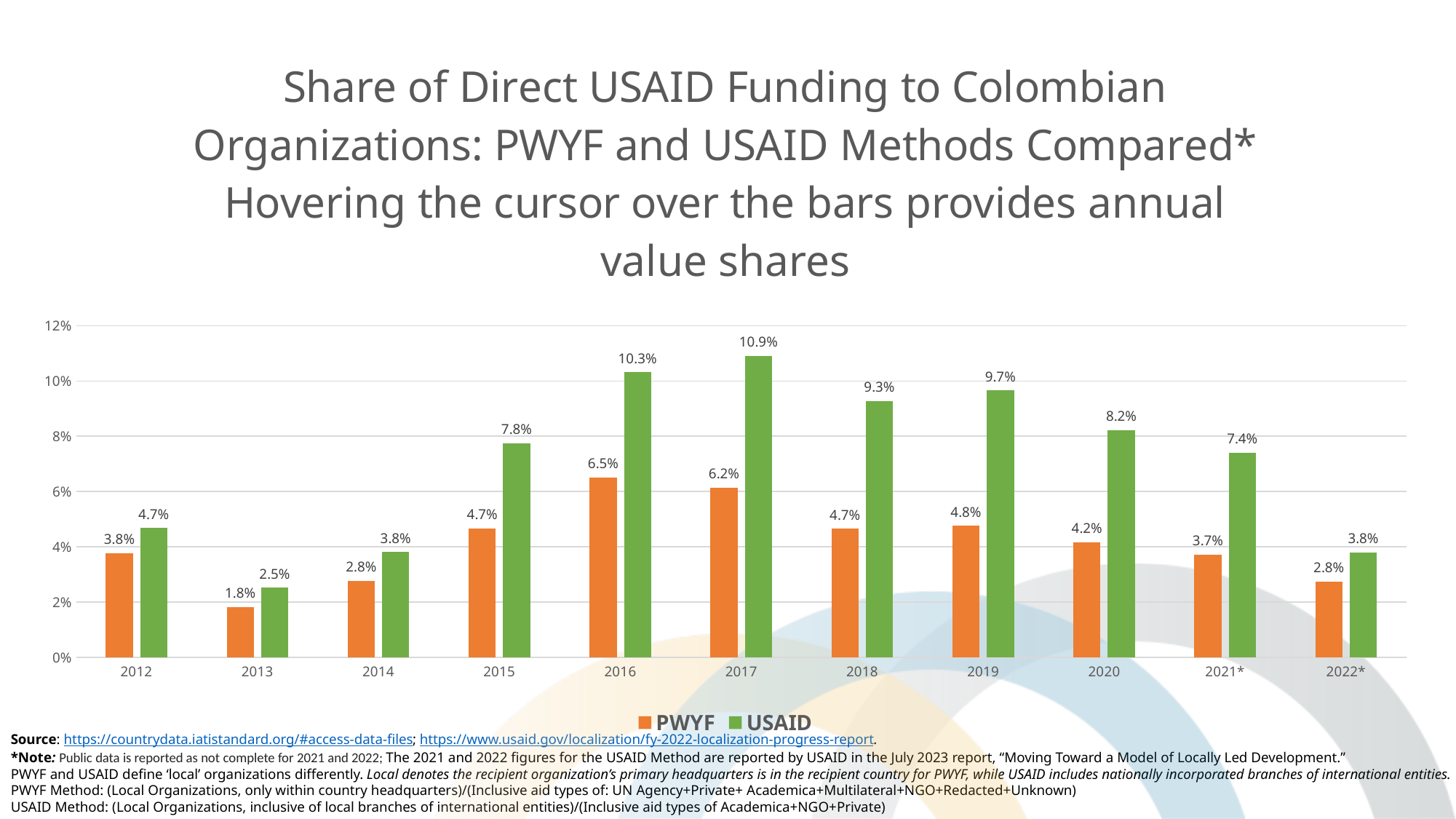
Which year has the lowest PWYF value? 2013 How many years are shown on the x axis? 11 What is the USAID value for 2017? 10.9% What kind of chart is shown on the slide? Bar chart Does the USAID value rise or fall from 2017 to 2022*? Fall Which year has the highest USAID value? 2017 Which is larger in 2019, the PWYF value or the USAID value? USAID How many series does the legend list? 2 What is the PWYF value for 2016? 6.5% Which colour represents the USAID series in the legend? Green What is the difference between the USAID and PWYF values in 2017? 4.7% What is the PWYF value for 2013? 1.8%